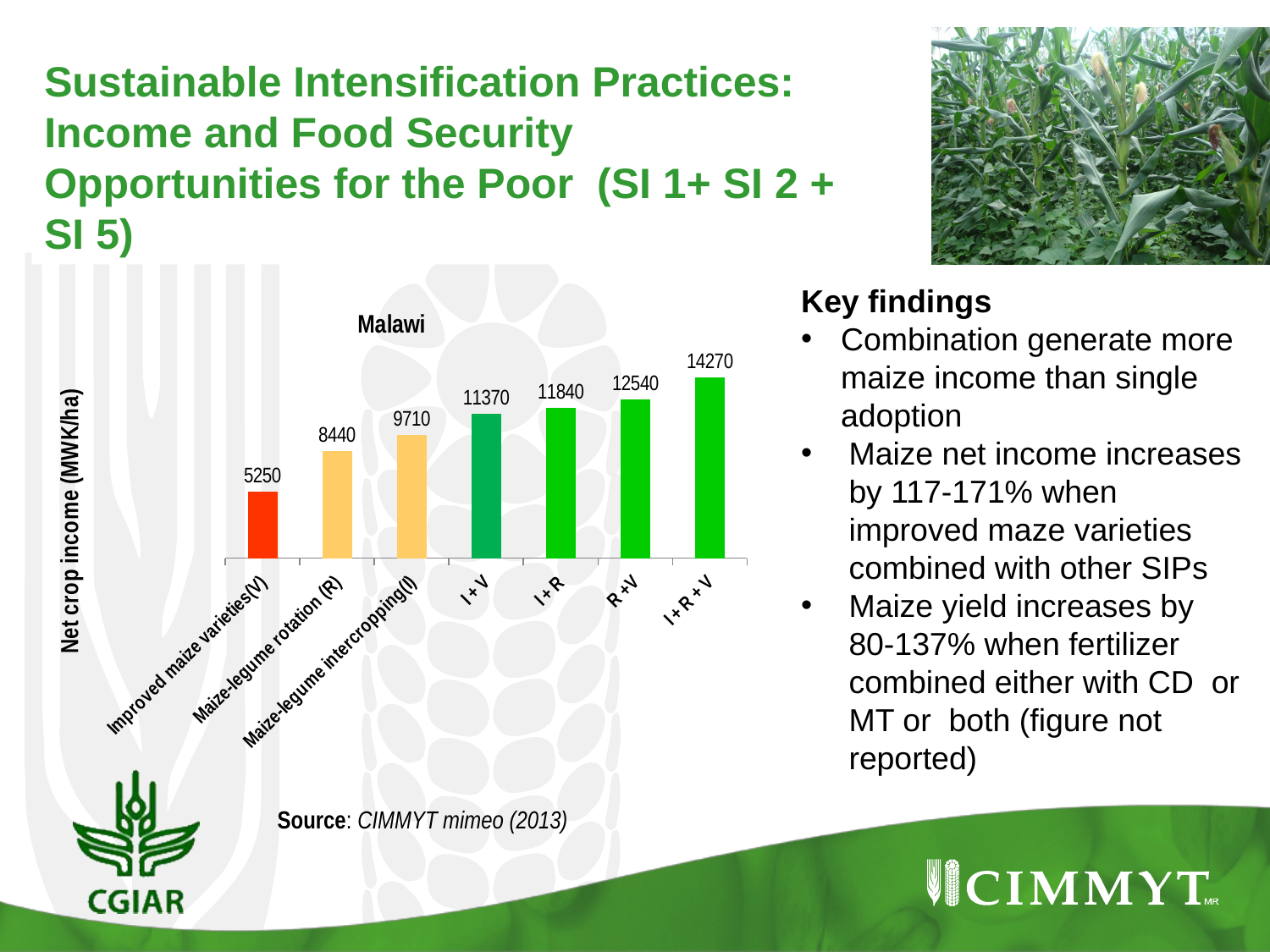
How many categories are shown on the chart? 7 What is the net crop income for I + R + V? 14270 Which has a higher net crop income, Maize-legume intercropping (I) or I + V? I + V What is the net crop income for Improved maize varieties (V)? 5250 Which category has the lowest net crop income? Improved maize varieties (V) What is the net crop income for R + V? 12540 What is the net crop income for Maize-legume rotation (R)? 8440 Which category has the highest net crop income? I + R + V What is the title of the chart? Malawi What kind of chart is shown on the slide? Bar chart What is the difference in net crop income between I + R and I + V? 470 What is the difference in net crop income between I + R + V and Improved maize varieties (V)? 9020